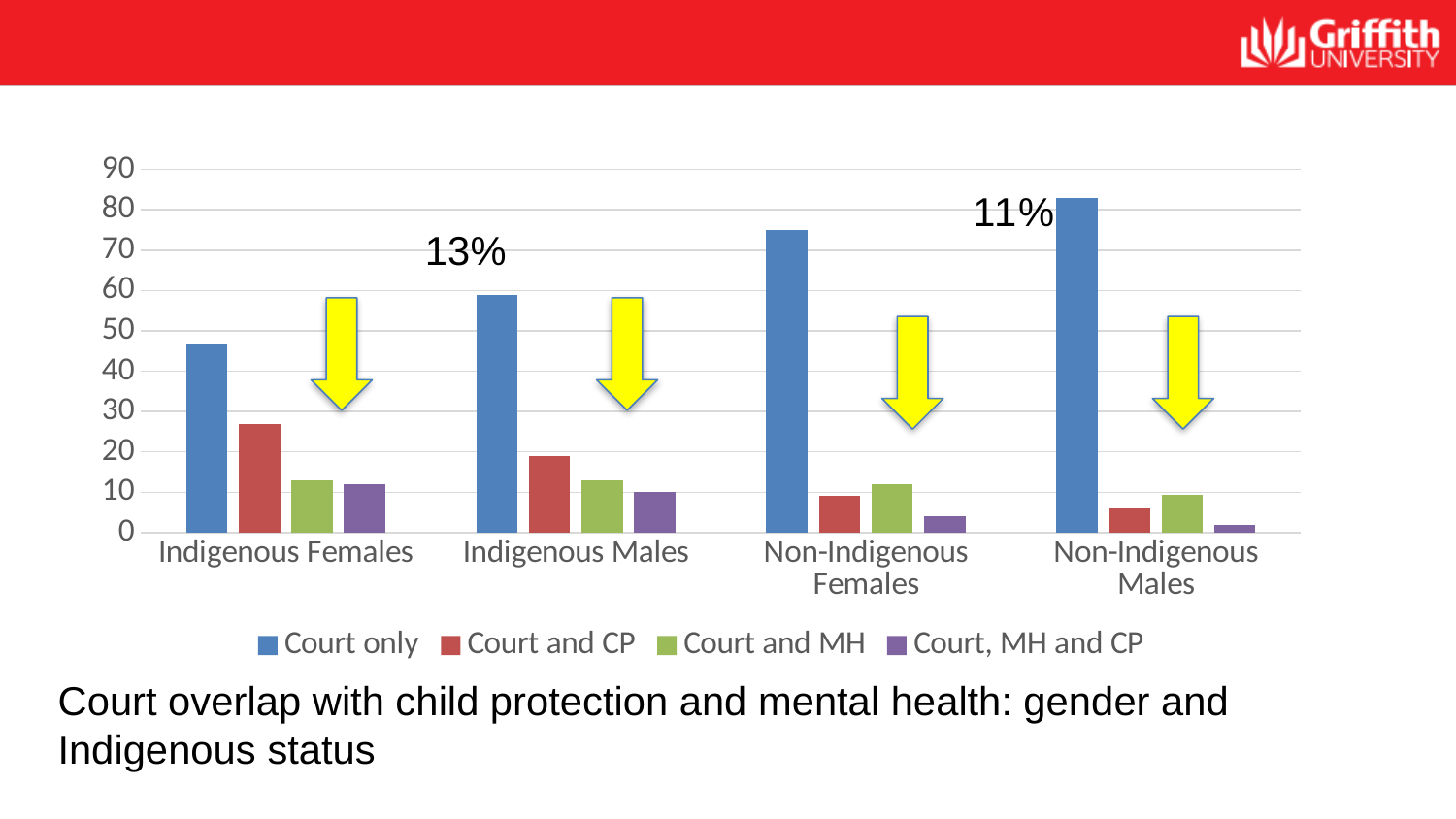
Is the Court only value for Non-Indigenous Females greater or less than 70? greater Which category has the lowest Court only bar? Indigenous Females Which series has the lowest bar for Non-Indigenous Males? Court, MH and CP What kind of chart is shown on the slide? bar chart Which series is shown in blue in the legend? Court only Which category has the highest Court only bar? Non-Indigenous Males Is the Court and CP value for Indigenous Females greater or less than 20? greater Is the Court only value for Indigenous Females greater or less than 50? less How many categories are shown on the x axis? 4 Which is larger: the Court and CP value for Indigenous Females or for Non-Indigenous Males? Indigenous Females Do the Court only values rise or fall moving from Indigenous Females to Non-Indigenous Males along the x axis? rise How many series does the legend list? 4